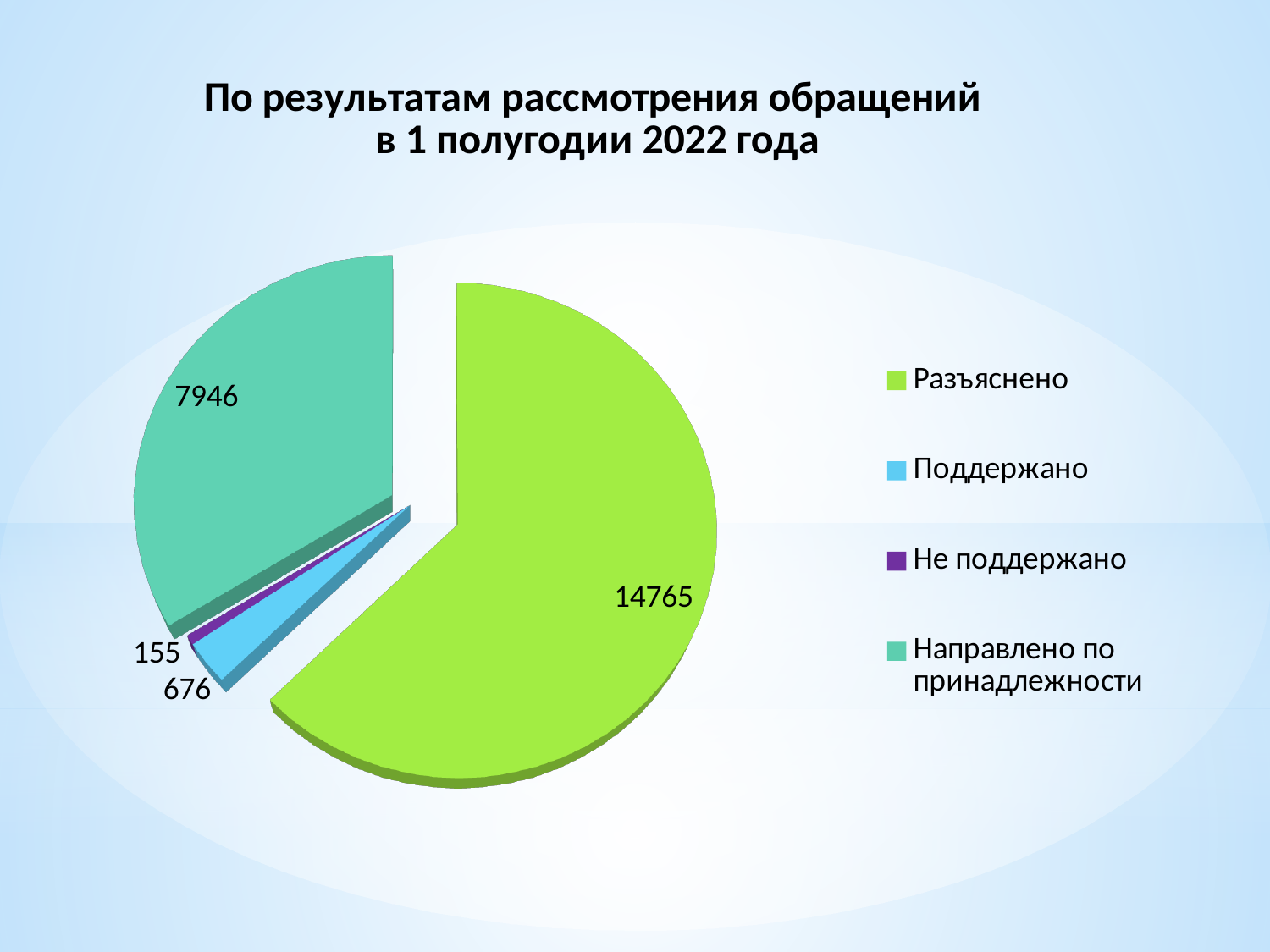
What is the difference between the values for Поддержано and Не поддержано? 521 What is the value for Не поддержано? 155 Which category has the smallest slice of the pie? Не поддержано What is the title of the chart? По результатам рассмотрения обращений в 1 полугодии 2022 года Which category has the largest slice of the pie? Разъяснено What is the value for Направлено по принадлежности? 7946 What type of chart is shown on the slide? Pie chart What is the value for Разъяснено? 14765 How many categories does the pie chart have? 4 Which is larger, the value for Поддержано or the value for Не поддержано? Поддержано What is the value for Поддержано? 676 What is the difference between the values for Разъяснено and Направлено по принадлежности? 6819